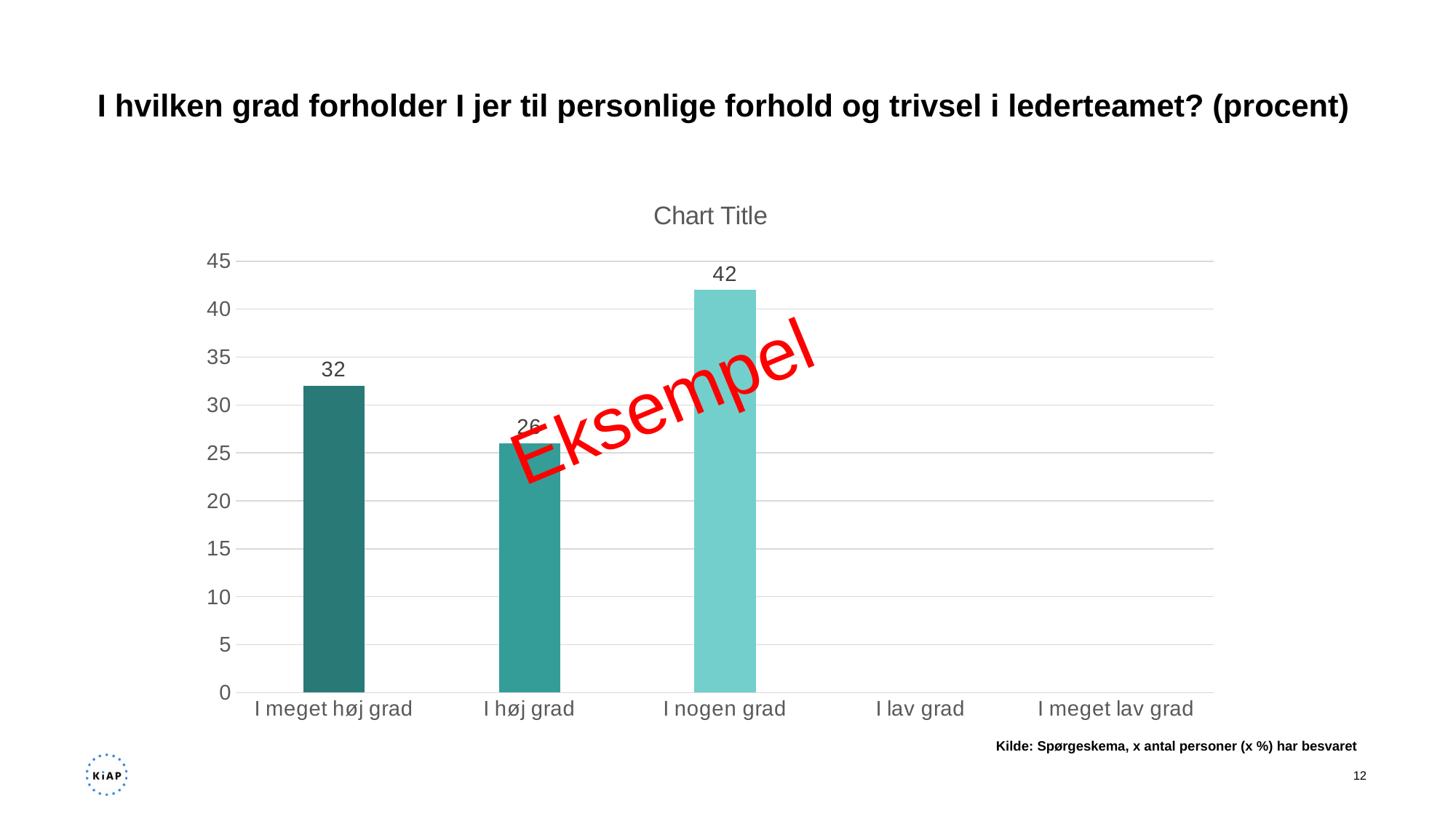
What is the difference between the values for "I meget høj grad" and "I høj grad"? 6 Which of the three categories with bars has the lowest value? I høj grad What is the value for "I meget høj grad"? 32 What is the difference between the values for "I nogen grad" and "I meget høj grad"? 10 Is the value for "I nogen grad" greater or less than 40? greater Which category has the highest value? I nogen grad What is the value for "I høj grad"? 26 Which is larger, the value for "I meget høj grad" or the value for "I høj grad"? I meget høj grad How many categories are shown on the x axis? 5 What is the title printed above the chart? Chart Title What is the value for "I nogen grad"? 42 What kind of chart is shown on the slide? Bar chart